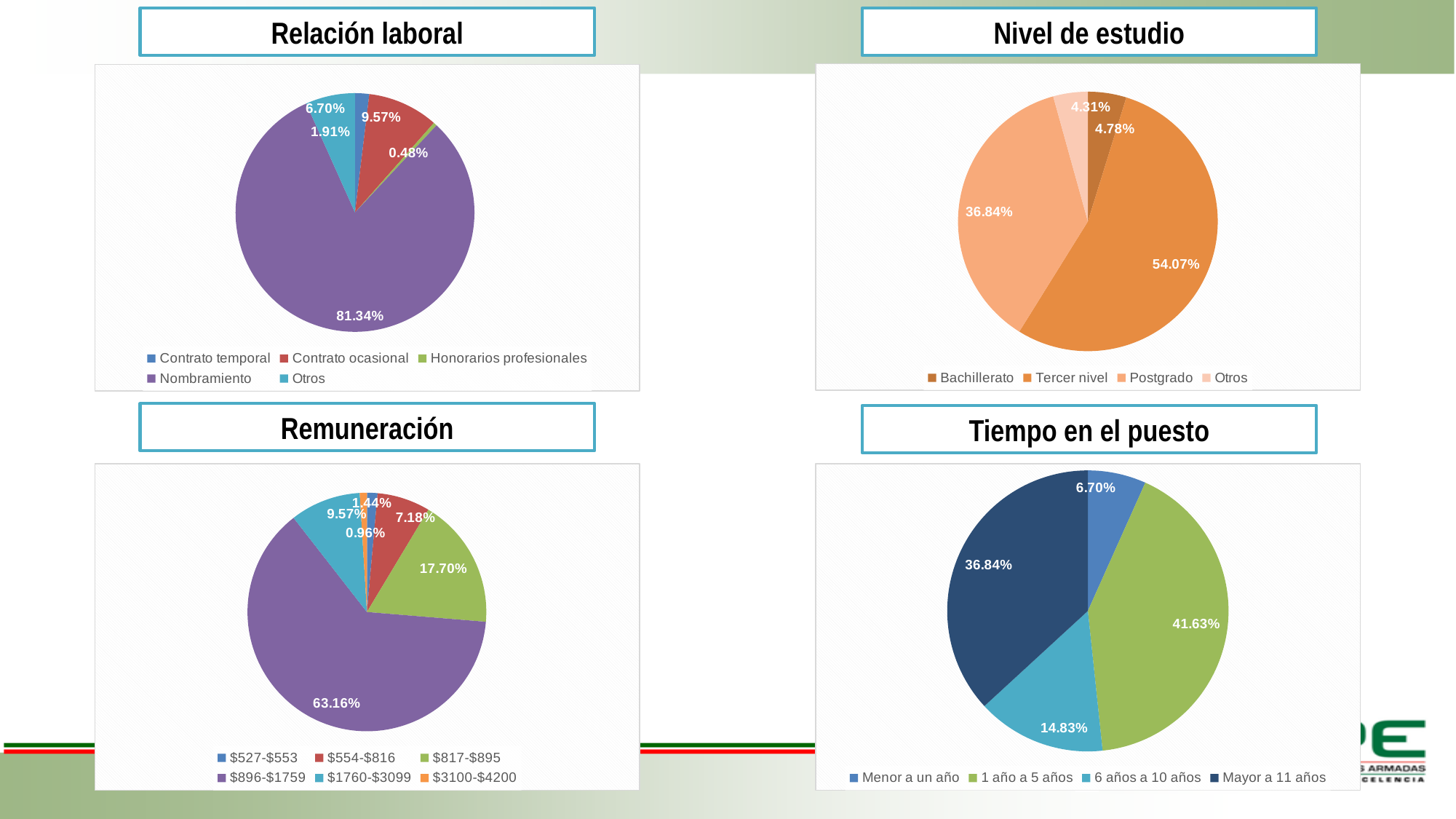
In the Nivel de estudio chart, what is the value for Tercer nivel? 54.07% What type of chart is the Tiempo en el puesto chart? Pie chart In the Nivel de estudio chart, what is the difference between Tercer nivel and Postgrado? 17.23% In the Remuneración chart, which category has the largest share? $896-$1759 In the Tiempo en el puesto chart, what is the value for 6 años a 10 años? 14.83% In the Tiempo en el puesto chart, what is the difference between 1 año a 5 años and Mayor a 11 años? 4.79% In the Relación laboral chart, which category has the smallest share? Honorarios profesionales In the Relación laboral chart, what is the value for Contrato ocasional? 9.57% In the Nivel de estudio chart, which is larger, Bachillerato or Otros? Bachillerato How many categories does the legend of the Remuneración chart list? 6 In the Relación laboral chart, what share does Nombramiento have? 81.34% In the Remuneración chart, what is the value for $817-$895? 17.70%